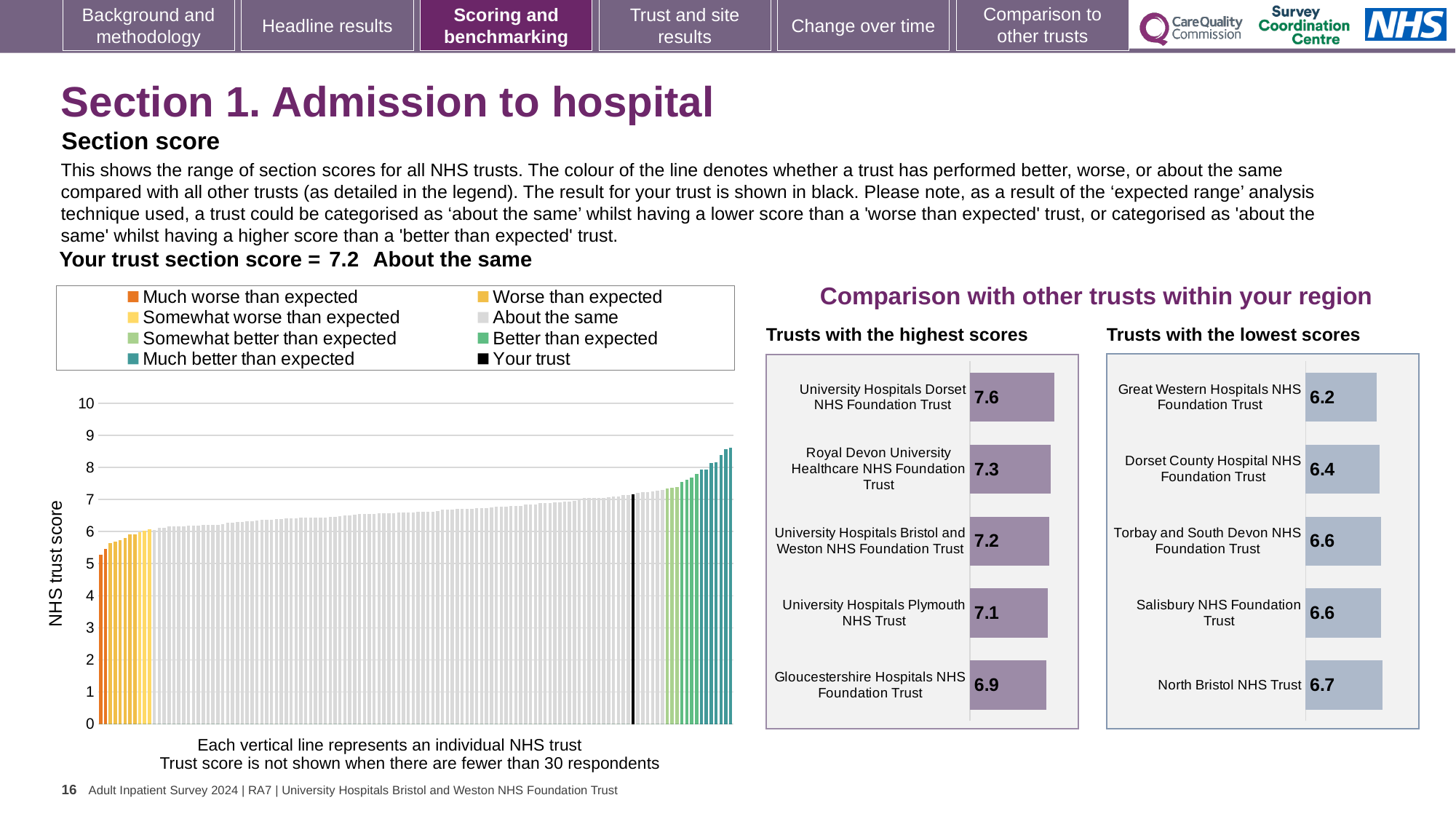
In the 'Trusts with the lowest scores' chart, which has the larger score: Dorset County Hospital NHS Foundation Trust or North Bristol NHS Trust? North Bristol NHS Trust In the main chart on the left showing the range of section scores, do the values rise or fall from left to right along the x axis? rise In the 'Trusts with the highest scores' chart, what is the score for Gloucestershire Hospitals NHS Foundation Trust? 6.9 How many entries does the legend of the main chart on the left list? 8 In the main chart on the left showing the range of section scores, is the value of the lowest-scoring trust (the leftmost bar) greater or less than 6? less How many trusts are shown in the 'Trusts with the lowest scores' chart? 5 In the 'Trusts with the lowest scores' chart, which trust has the highest score? North Bristol NHS Trust In the 'Trusts with the highest scores' chart, what is the difference between the scores of University Hospitals Dorset NHS Foundation Trust and Gloucestershire Hospitals NHS Foundation Trust? 0.7 In the 'Trusts with the highest scores' chart, what is the score for University Hospitals Dorset NHS Foundation Trust? 7.6 What kind of chart is the main chart on the left showing the range of NHS trust section scores? bar chart In the 'Trusts with the highest scores' chart, which trust has the lowest score? Gloucestershire Hospitals NHS Foundation Trust In the 'Trusts with the lowest scores' chart, what is the score for Great Western Hospitals NHS Foundation Trust? 6.2